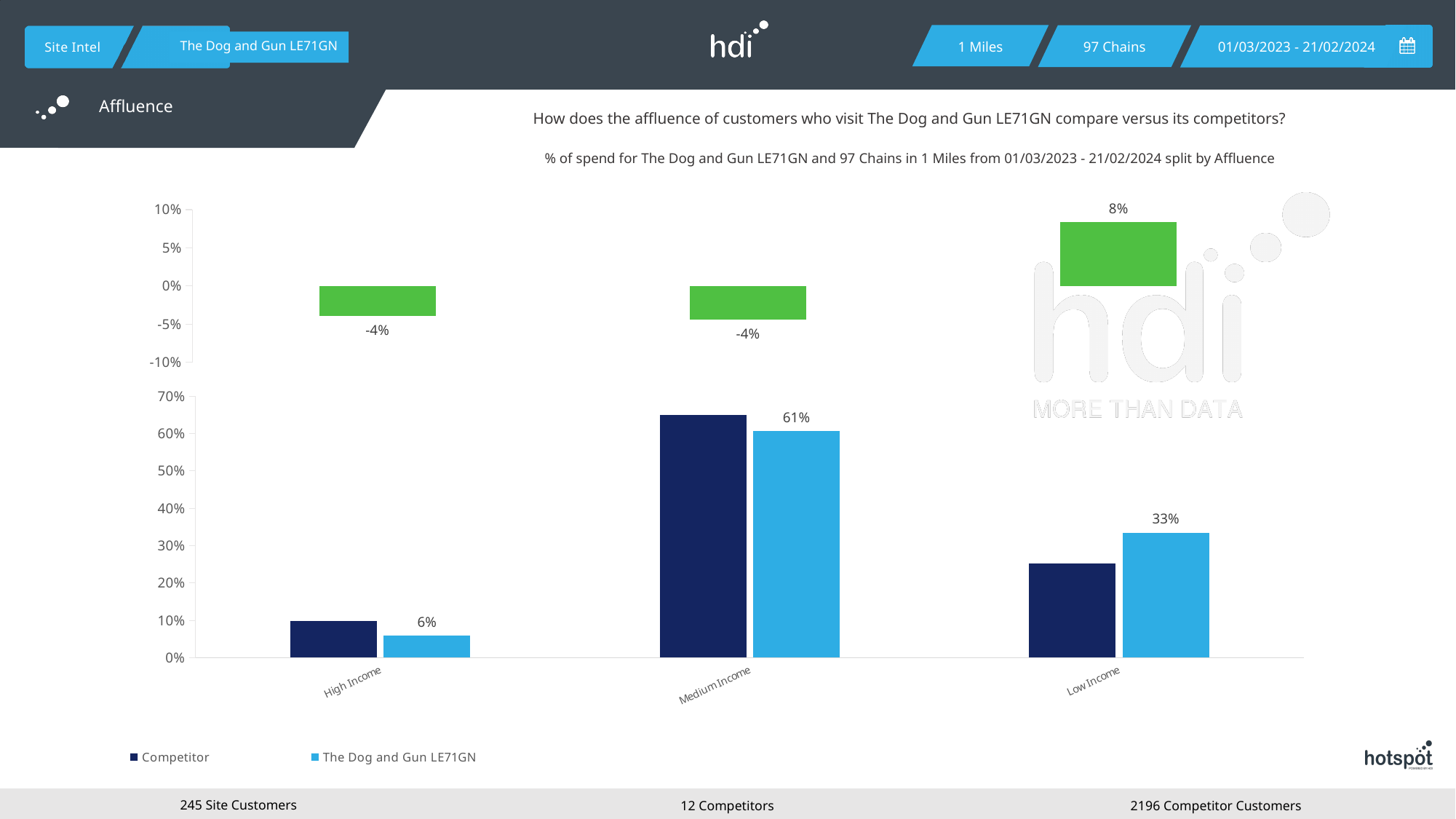
In the bottom chart, what is the value for The Dog and Gun LE71GN in the Medium Income category? 61% In the top chart (green bars), what is the value for High Income? -4% In the bottom chart, which category has the highest value for The Dog and Gun LE71GN? Medium Income In the bottom chart, which is larger for Low Income: Competitor or The Dog and Gun LE71GN? The Dog and Gun LE71GN In the bottom chart, what is the value for The Dog and Gun LE71GN in the High Income category? 6% In the bottom chart, which category has the lowest value for The Dog and Gun LE71GN? High Income How many series does the legend of the bottom chart list? 2 In the bottom chart, is the Competitor value for Low Income greater or less than 30%? less In the bottom chart, what is the difference between The Dog and Gun LE71GN values for Medium Income and Low Income? 28% In the bottom chart, is the Competitor value for Medium Income greater or less than 60%? greater In the bottom chart, what is the value for The Dog and Gun LE71GN in the Low Income category? 33% In the top chart (green bars), what is the value for Low Income? 8%